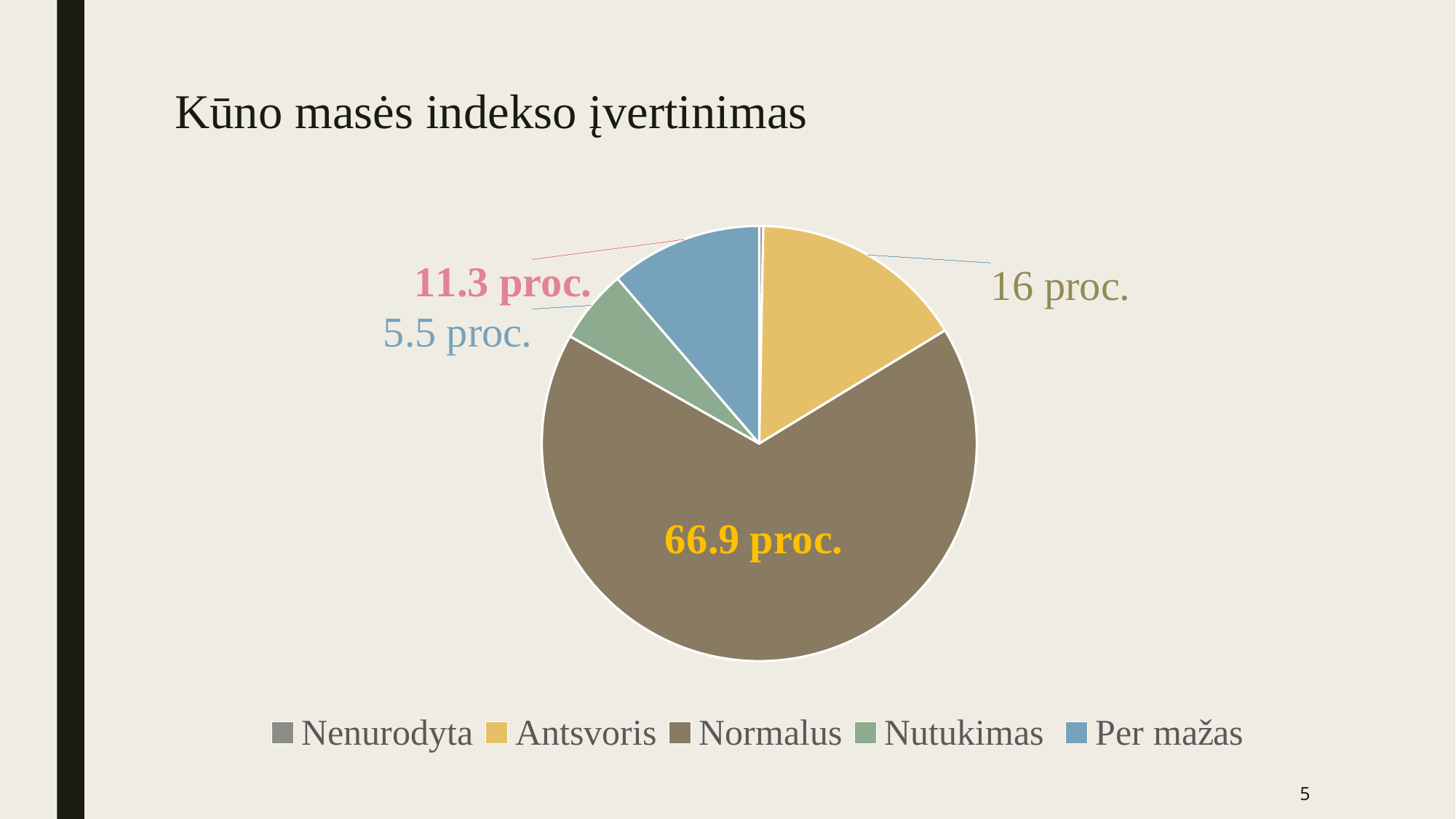
Which is larger, Antsvoris or Per mažas? Antsvoris What is the value for Per mažas? 11.3 proc. What is the value for Nutukimas? 5.5 proc. What is the difference between the values for Per mažas and Nutukimas? 5.8 proc. What is the value for Antsvoris? 16 proc. Which category has the largest share of the pie? Normalus How many categories does the legend list? 5 What is the difference between the values for Normalus and Antsvoris? 50.9 proc. What is the title of the slide? Kūno masės indekso įvertinimas What is the value for Normalus? 66.9 proc. What type of chart is shown on the slide? Pie chart Which category has the smallest share of the pie? Nenurodyta